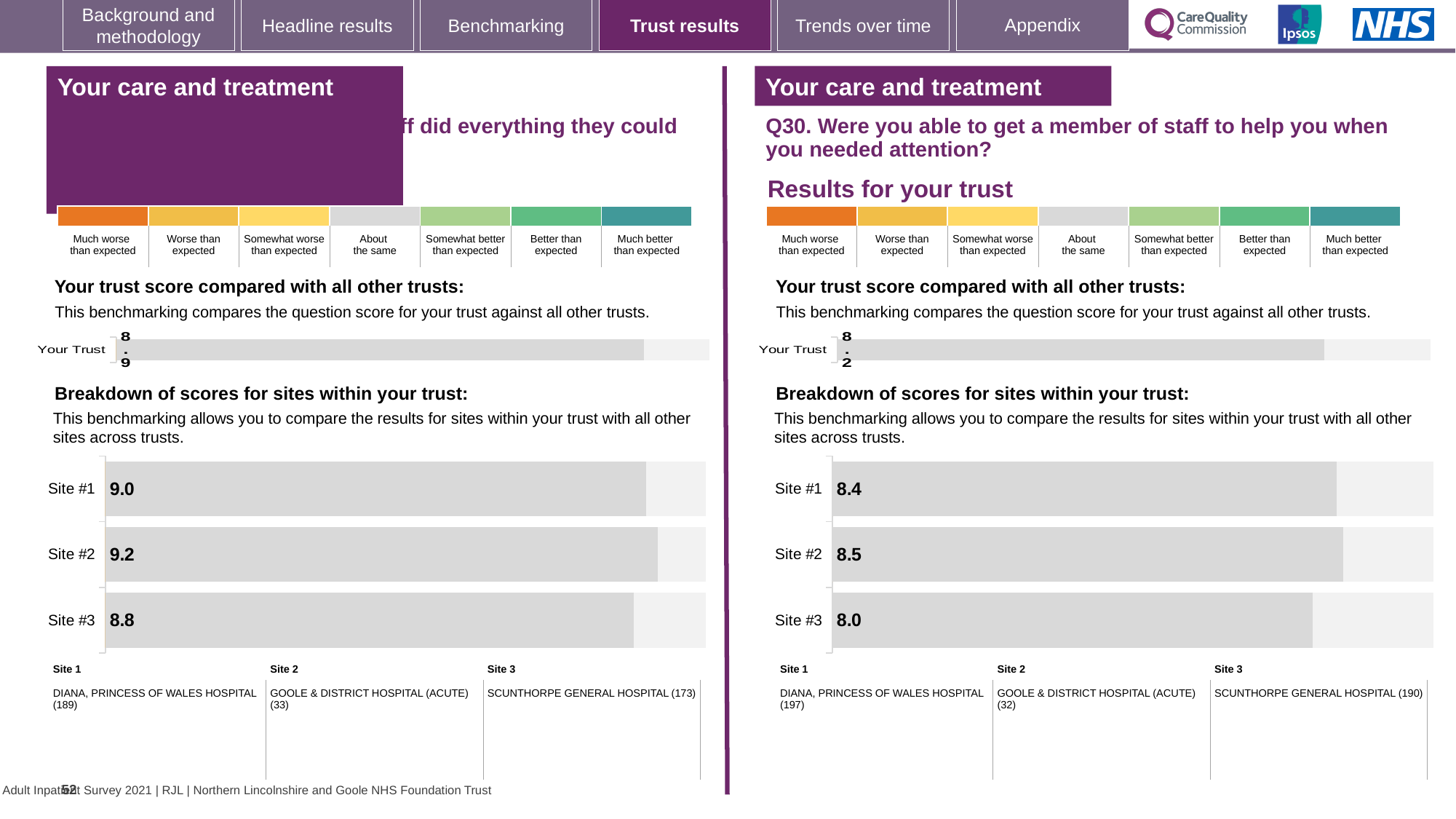
On the left-hand site breakdown chart, which site has the lowest score? Site #3 On the left-hand site breakdown chart, which is larger: the score for Site #1 or Site #3? Site #1 On the right-hand chart for Q30, which site has the highest score? Site #2 What kind of chart is used for the site breakdown on the right-hand side of the slide? Bar chart On the right-hand chart for Q30, what is the score for Site #3? 8.0 How many sites are shown in the right-hand site breakdown chart for Q30? 3 On the right-hand side for Q30, what is the 'Your Trust' score shown in the trust comparison chart? 8.2 On the left-hand site breakdown chart, what is the score for Site #3? 8.8 On the right-hand chart for Q30, what is the difference between the scores for Site #2 and Site #3? 0.5 On the left-hand site breakdown chart, what is the score for Site #2? 9.2 On the left-hand site breakdown chart, what is the difference between the scores for Site #2 and Site #3? 0.4 On the right-hand chart for Q30, what is the score for Site #1? 8.4